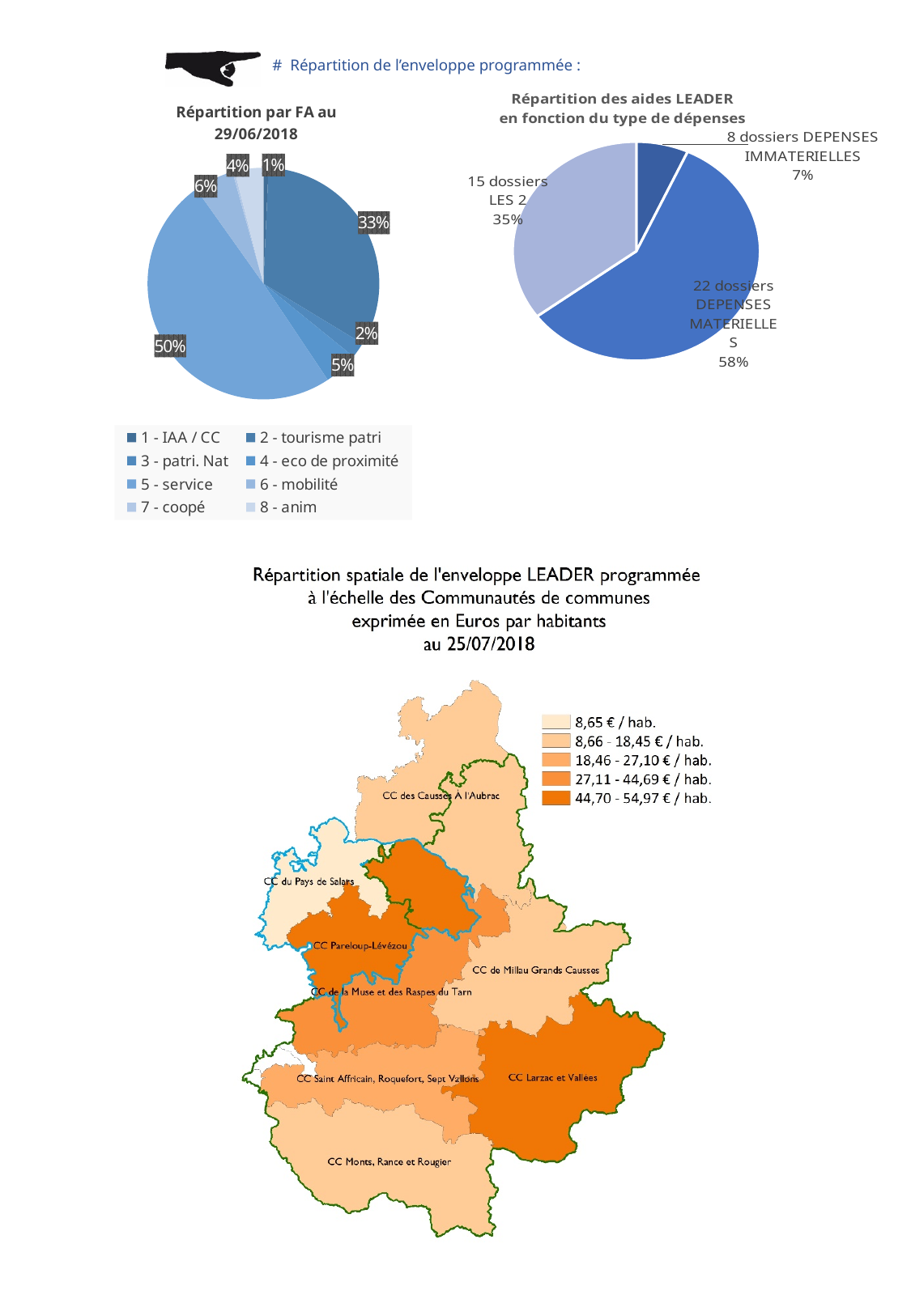
In the chart 'Répartition des aides LEADER en fonction du type de dépenses', how many dossiers are shown for LES 2? 15 dossiers What kind of chart is 'Répartition par FA au 29/06/2018'? Pie chart In the chart 'Répartition des aides LEADER en fonction du type de dépenses', what share is shown for DEPENSES MATERIELLES? 58% How many entries does the legend of the chart 'Répartition par FA au 29/06/2018' list? 8 In the chart 'Répartition des aides LEADER en fonction du type de dépenses', which has more dossiers: LES 2 or DEPENSES IMMATERIELLES? LES 2 In the chart 'Répartition des aides LEADER en fonction du type de dépenses', what is the difference in percentage points between DEPENSES MATERIELLES and DEPENSES IMMATERIELLES? 51 In the chart 'Répartition des aides LEADER en fonction du type de dépenses', which category has the smallest share? DEPENSES IMMATERIELLES In the chart 'Répartition par FA au 29/06/2018', what is the largest percentage shown on a slice? 50% In the chart 'Répartition des aides LEADER en fonction du type de dépenses', what share is shown for DEPENSES IMMATERIELLES? 7% In the chart 'Répartition des aides LEADER en fonction du type de dépenses', which category has the largest share? DEPENSES MATERIELLES In the chart 'Répartition des aides LEADER en fonction du type de dépenses', how many slices does the pie have? 3 In the chart 'Répartition par FA au 29/06/2018', what is the smallest percentage labelled on a slice? 1%